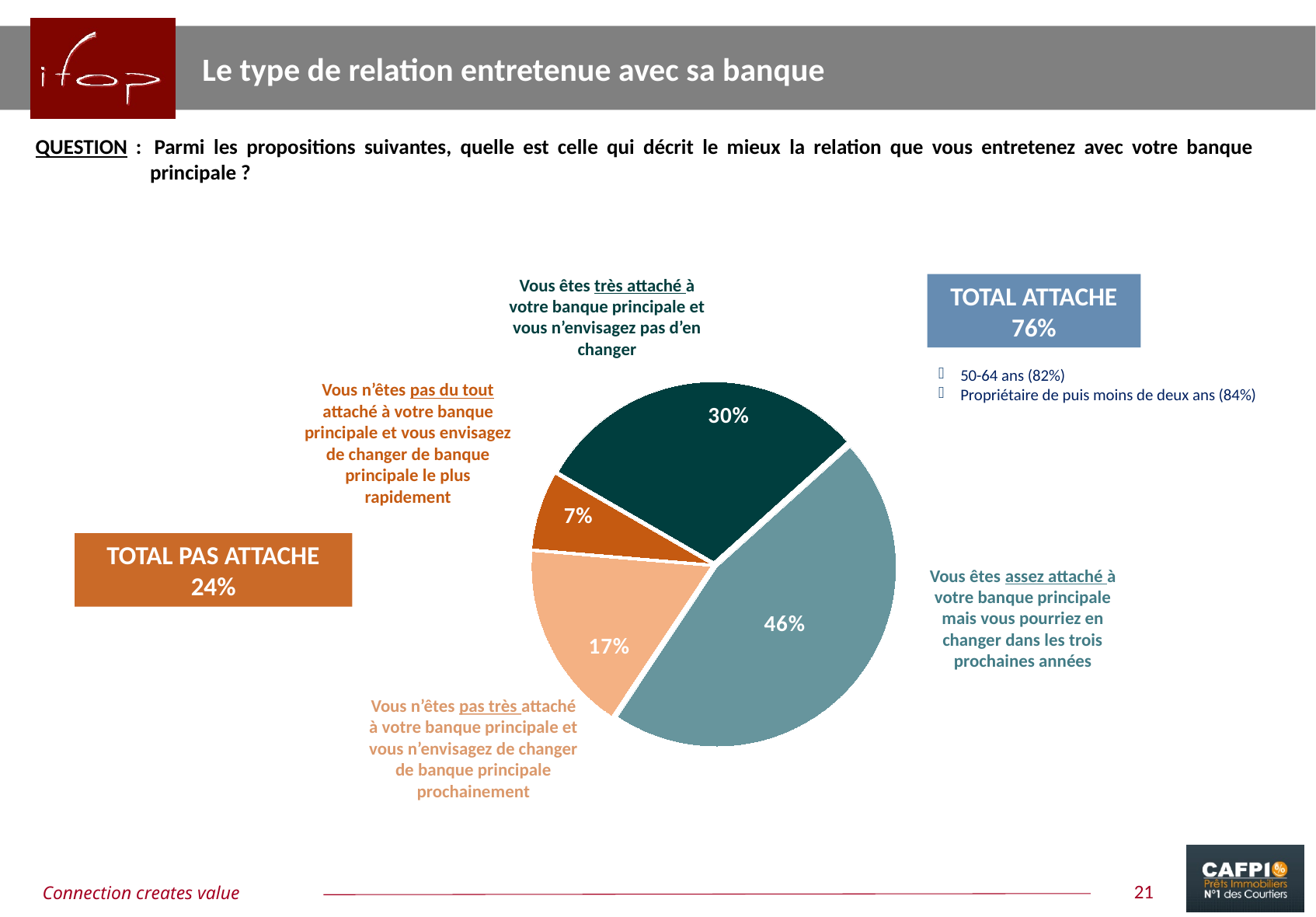
What is the difference between the 'assez attaché' share and the 'très attaché' share? 16 points What is the value shown in the 'TOTAL ATTACHE' box? 76% What is the value shown in the 'TOTAL PAS ATTACHE' box? 24% Which response has the largest slice of the pie? Vous êtes assez attaché à votre banque principale mais vous pourriez en changer dans les trois prochaines années What share of respondents say they are 'assez attaché' to their main bank but could change in the next three years? 46% Which is larger: the 'pas très attaché' share or the 'pas du tout attaché' share? pas très attaché (17%) What share of respondents say they are 'pas du tout attaché' to their main bank? 7% What share of respondents say they are 'très attaché' to their main bank and do not plan to change? 30% What kind of chart is shown on the slide? pie chart How many slices does the pie chart have? 4 Which response has the smallest slice of the pie? Vous n'êtes pas du tout attaché à votre banque principale et vous envisagez de changer de banque principale le plus rapidement What share of respondents say they are 'pas très attaché' to their main bank? 17%